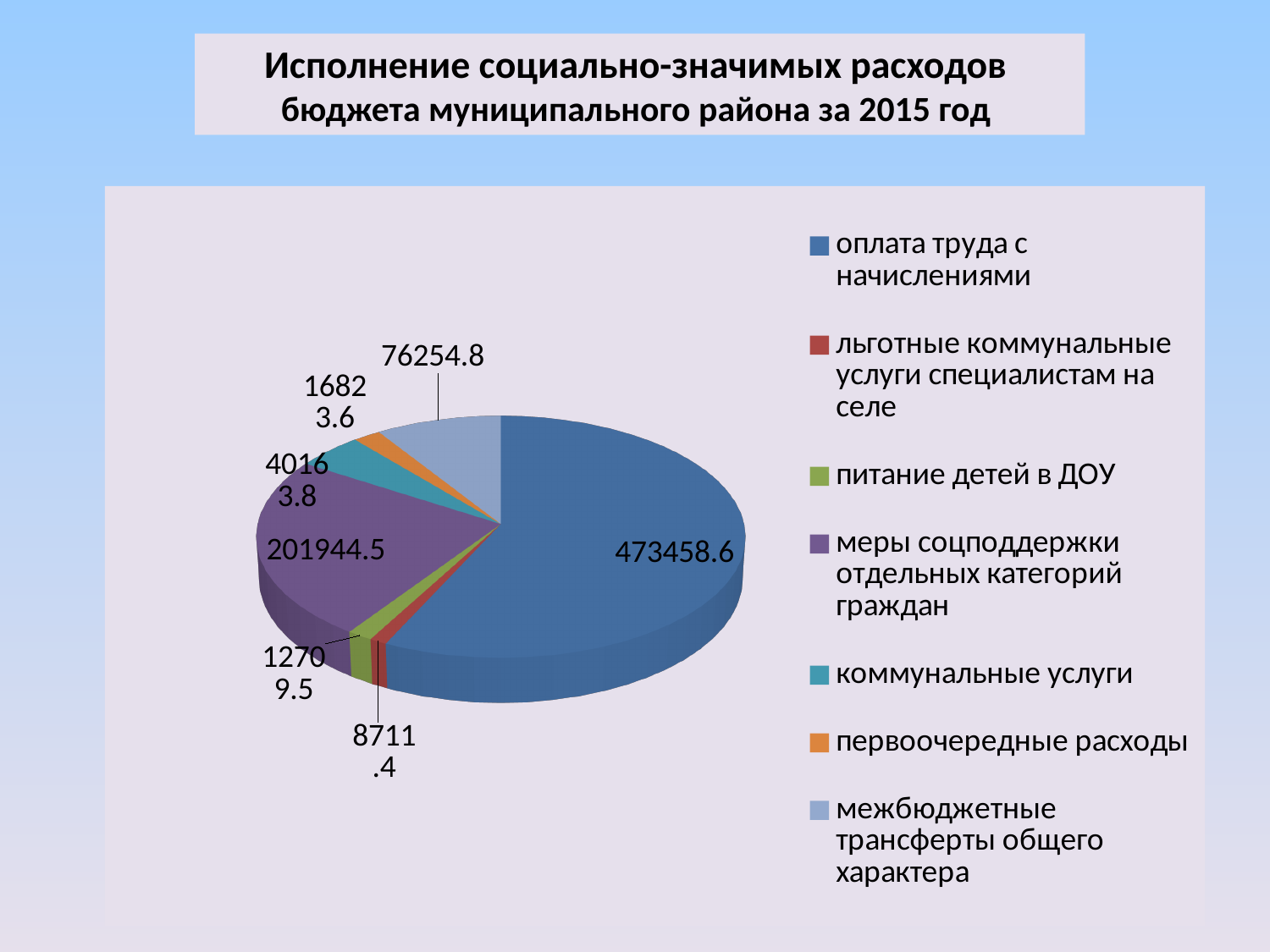
What is the value for оплата труда с начислениями? 473458.6 How many categories does the pie chart show? 7 What colour is the slice for коммунальные услуги? teal What is the value for меры соцподдержки отдельных категорий граждан? 201944.5 What is the difference between the values for оплата труда с начислениями and меры соцподдержки отдельных категорий граждан? 271514.1 What is the value for межбюджетные трансферты общего характера? 76254.8 What is the value for льготные коммунальные услуги специалистам на селе? 8711.4 Which category has the smallest slice of the pie? льготные коммунальные услуги специалистам на селе What type of chart is shown on the slide? pie chart Which category has the largest slice of the pie? оплата труда с начислениями What is the value for коммунальные услуги? 40163.8 Which is larger: the value for первоочередные расходы or the value for питание детей в ДОУ? первоочередные расходы